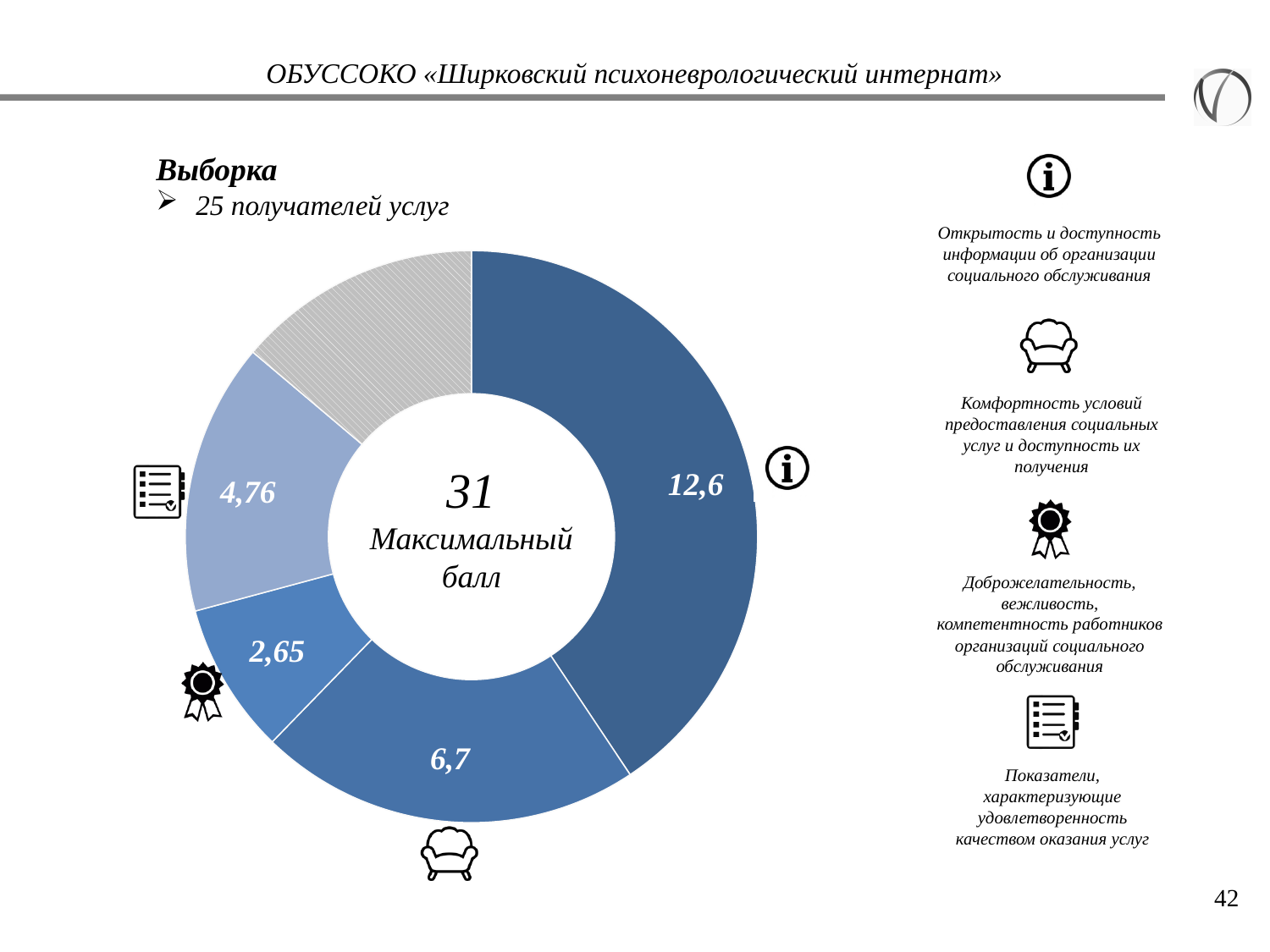
What value is shown for the slice marked with the checklist icon (Показатели, характеризующие удовлетворенность качеством оказания услуг)? 4,76 What value is shown for the slice marked with the award icon (Доброжелательность, вежливость, компетентность работников)? 2,65 What maximum score is shown in the centre of the donut chart? 31 What is the difference between the value for the information icon slice (12,6) and the armchair icon slice (6,7)? 5,9 How many slices in the chart have a printed value label? 4 What value is shown for the slice marked with the information icon (Открытость и доступность информации об организации социального обслуживания)? 12,6 Which is larger: the value for the checklist icon slice or the award icon slice? The checklist icon slice (4,76) What type of chart is shown on the slide? Donut (pie) chart Which labeled slice has the highest value? 12,6 (Открытость и доступность информации) How many service recipients were in the sample (Выборка) according to the slide? 25 What value is shown for the slice marked with the armchair icon (Комфортность условий предоставления социальных услуг и доступность их получения)? 6,7 Which labeled slice has the lowest value? 2,65 (Доброжелательность, вежливость, компетентность работников)